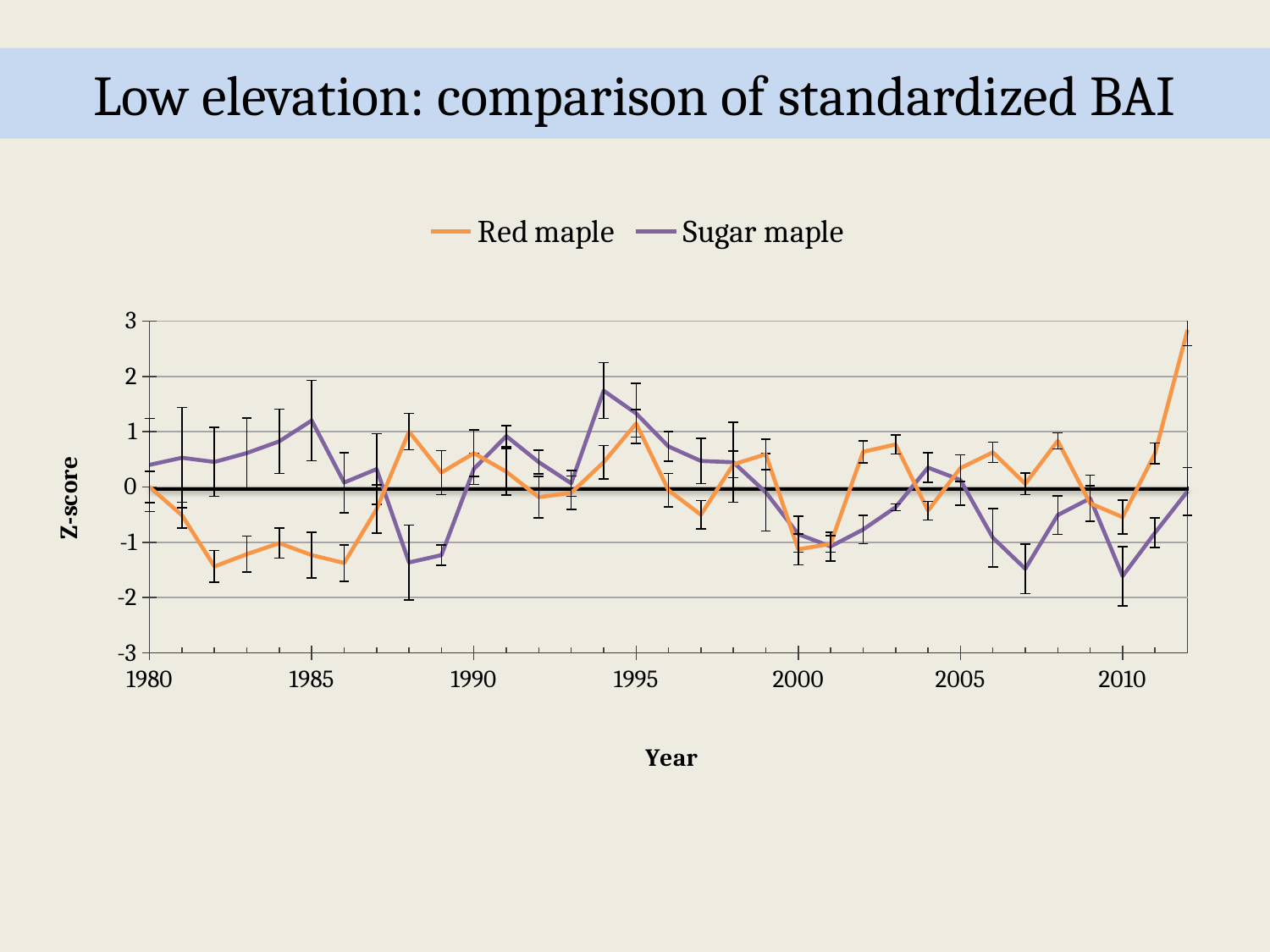
Is the Sugar maple value in 1994 greater or less than 1? greater Is the Red maple value in 1982 greater or less than -1? less In 1988, which series has the larger value, Red maple or Sugar maple? Red maple How many series does the legend list? 2 Is the Red maple value in 2012 greater or less than 2? greater In which year does the Red maple series reach its highest value? 2012 What kind of chart is shown on the slide? line chart In 1982, which series has the larger value, Red maple or Sugar maple? Sugar maple What is the title of the chart on the slide? Low elevation: comparison of standardized BAI In which year does the Sugar maple series reach its highest value? 1994 What label is on the vertical axis of the chart? Z-score